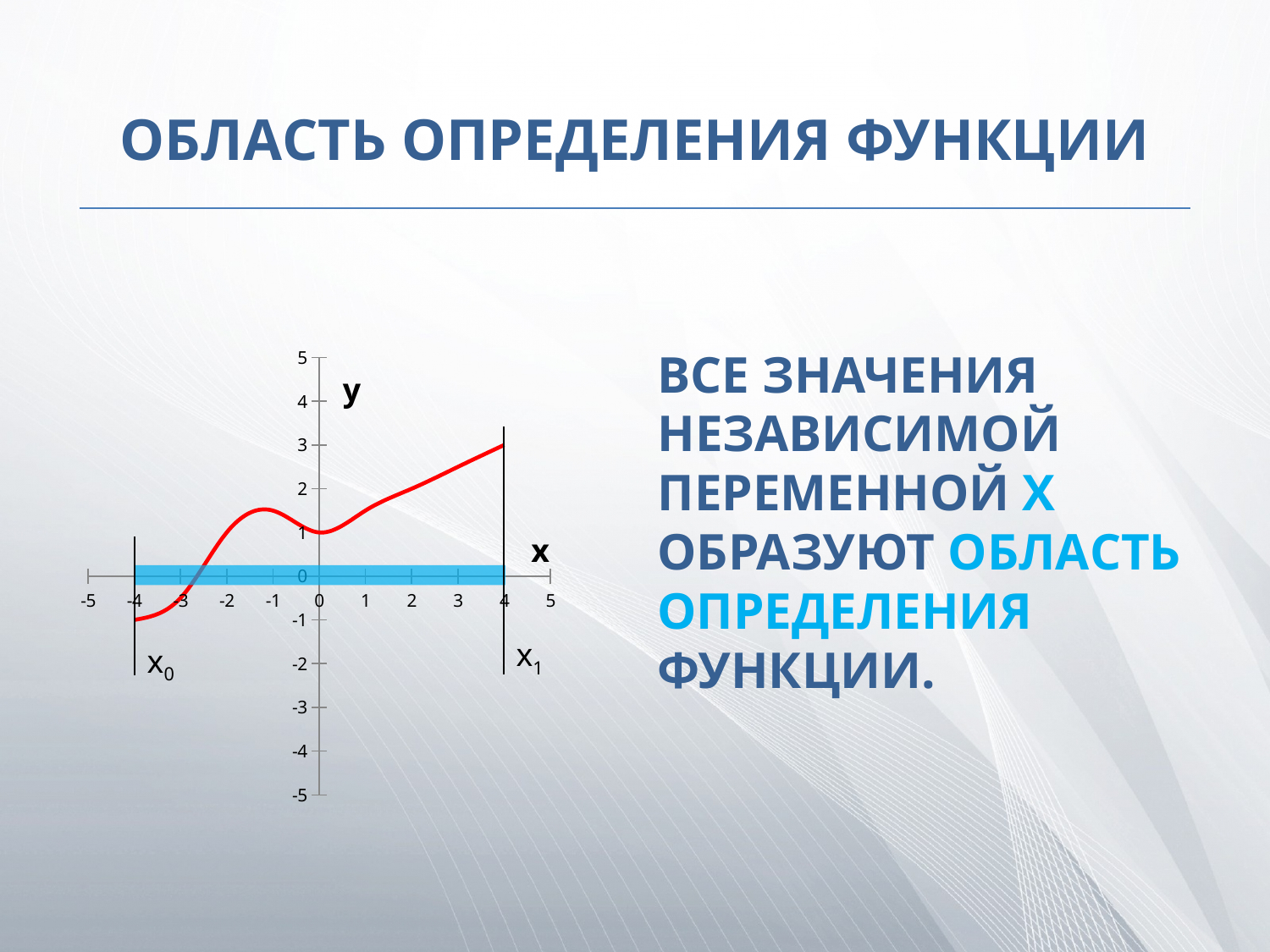
What is the lowest value labelled on the x axis? -5 What is the highest value labelled on the y axis? 5 What label marks the left vertical boundary line of the domain? x0 Does the function rise or fall as x goes from -4 to -1? rises At x = 4, is the value of the function greater or less than 2? greater At x = 2, is the value of the function greater or less than 1? greater Does the function rise or fall as x goes from 0 to 4? rises At x = -4, is the value of the function greater or less than 0? less How many tick labels are shown along the x axis? 11 Which is larger, the value of the function at x = 4 or at x = -4? at x = 4 What kind of chart is shown on the slide? line chart